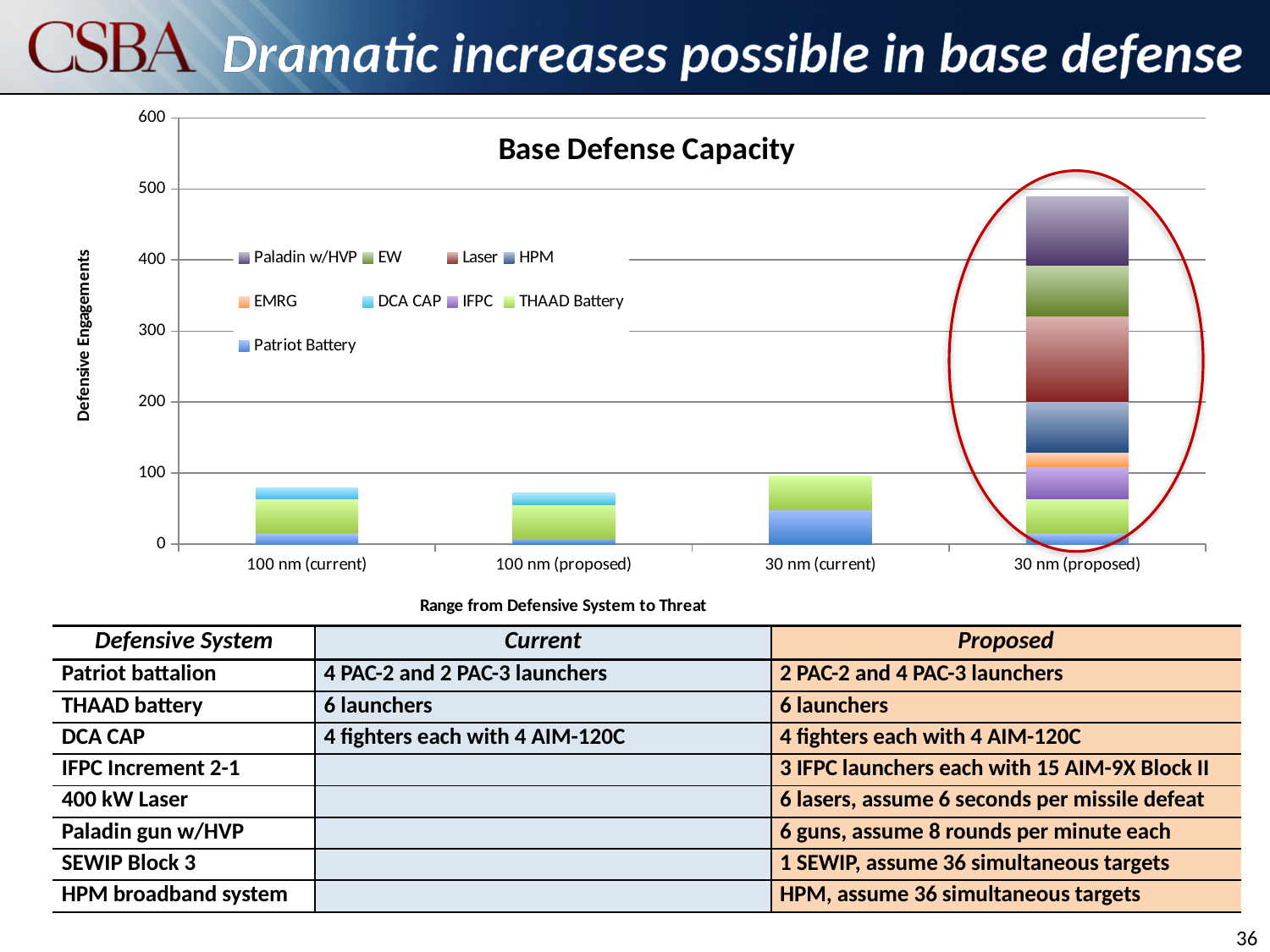
What is the title of the chart? Base Defense Capacity Which category has the highest total defensive engagements? 30 nm (proposed) Is the total for 30 nm (current) greater or less than 200? less Is the total for 30 nm (proposed) greater or less than 400? greater Is the total for 100 nm (current) greater or less than 100? less How many series does the chart legend list? 9 Which bar is circled in red on the chart? 30 nm (proposed) How many categories are shown on the x axis of the chart? 4 What kind of chart is shown on the slide? Stacked bar chart What is the label of the y axis? Defensive Engagements Which has a larger total, 30 nm (current) or 30 nm (proposed)? 30 nm (proposed)